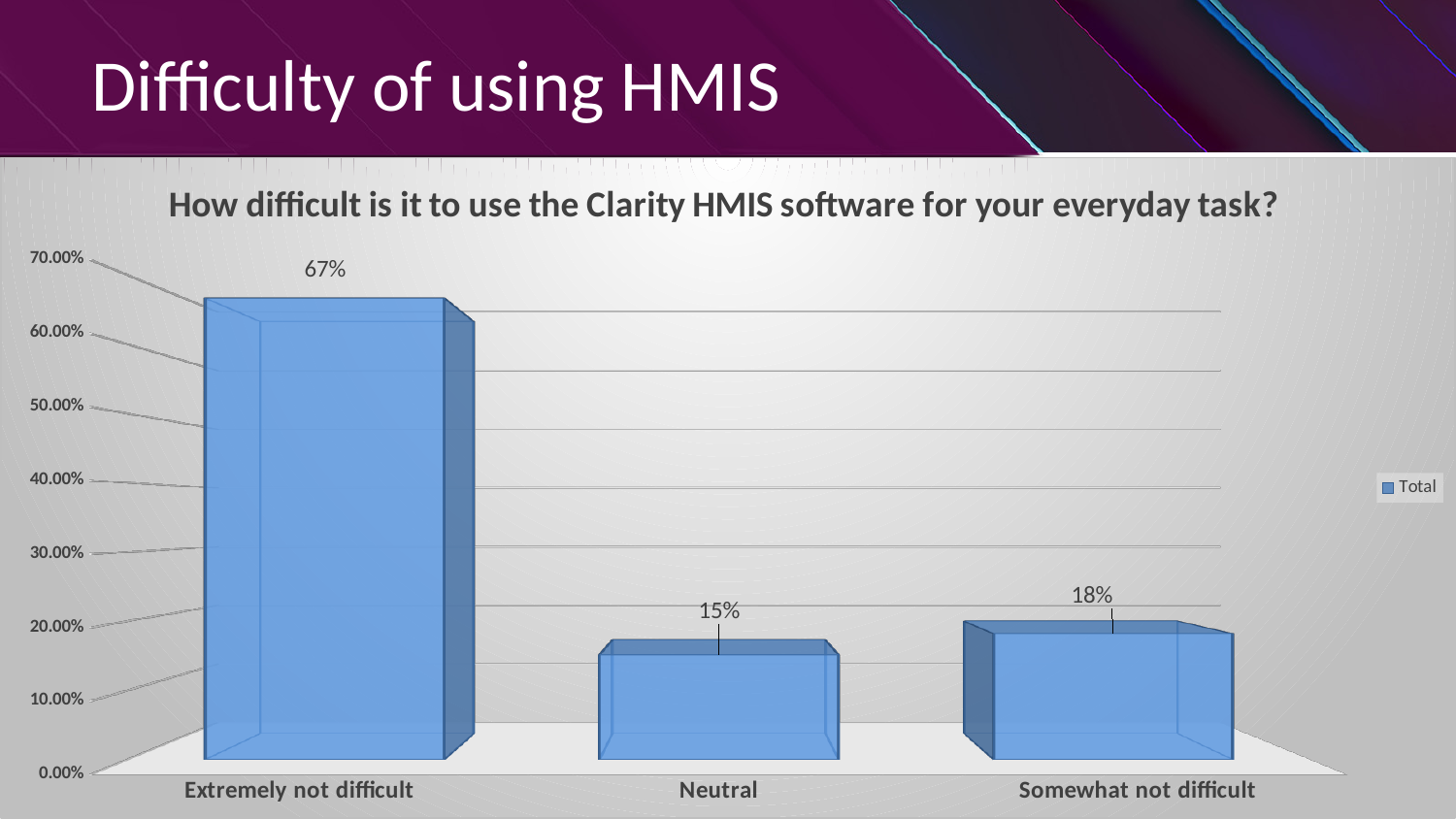
How many categories are shown on the x axis? 3 Which category has the highest value? Extremely not difficult Which is larger, the value for Neutral or the value for Somewhat not difficult? Somewhat not difficult What kind of chart is shown on the slide? Bar chart What is the value for Neutral? 15% What is the value for Somewhat not difficult? 18% What is the difference between the values for Extremely not difficult and Somewhat not difficult? 49% What is the title of the chart? How difficult is it to use the Clarity HMIS software for your everyday task? How many series does the legend list? 1 What is the difference between the values for Somewhat not difficult and Neutral? 3% What is the value for Extremely not difficult? 67% Which category has the lowest value? Neutral